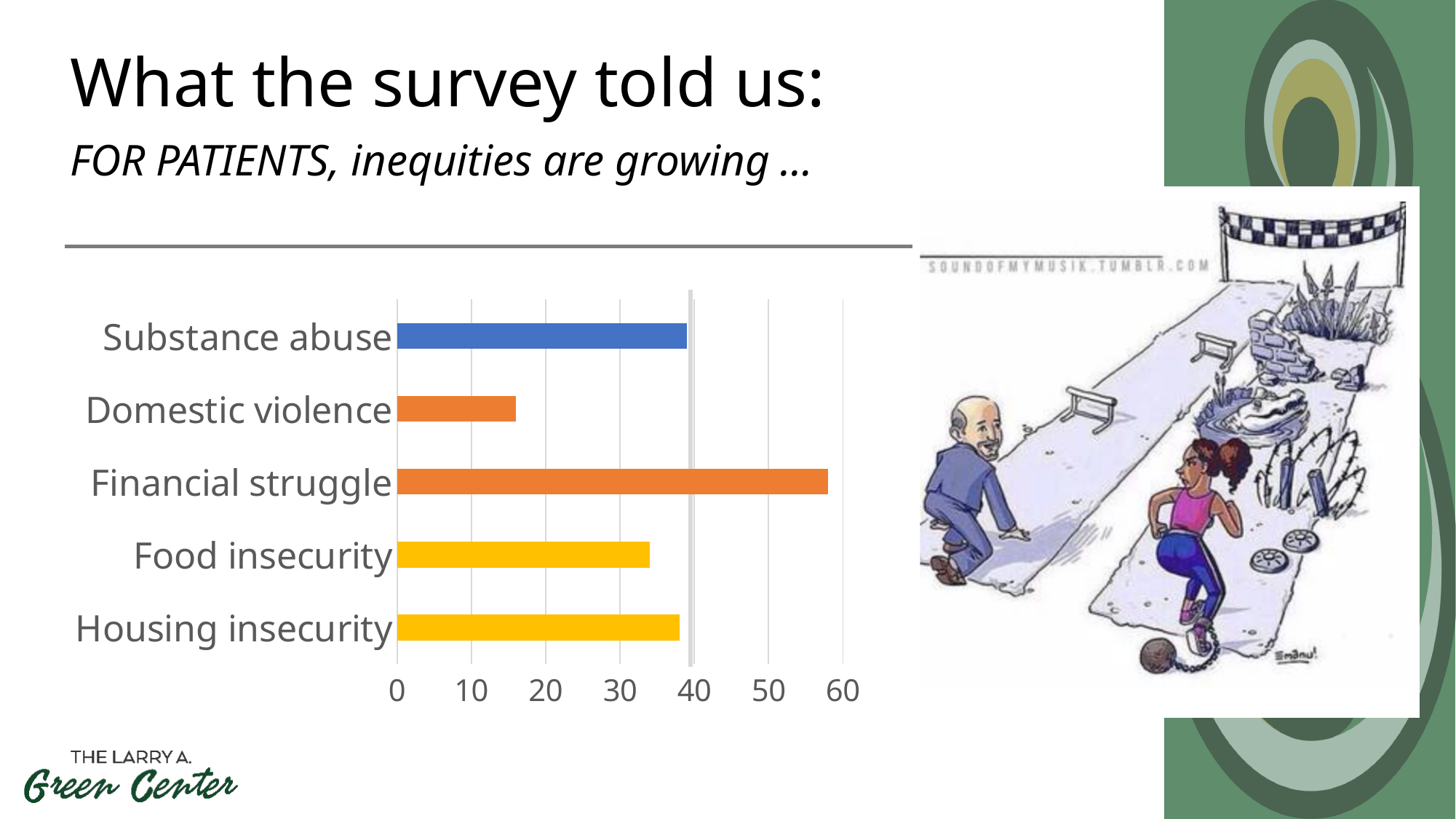
Is the value for Substance abuse greater or less than 30? greater Which is larger, the value for Financial struggle or the value for Food insecurity? Financial struggle Is the value for Food insecurity greater or less than 30? greater Is the value for Domestic violence greater or less than 20? less Which category has the highest value in the bar chart? Financial struggle How many categories are plotted in the bar chart? 5 What is the highest value shown on the x axis of the bar chart? 60 What kind of chart is shown on the slide? bar chart Which is larger, the value for Domestic violence or the value for Substance abuse? Substance abuse Which category has the lowest value in the bar chart? Domestic violence